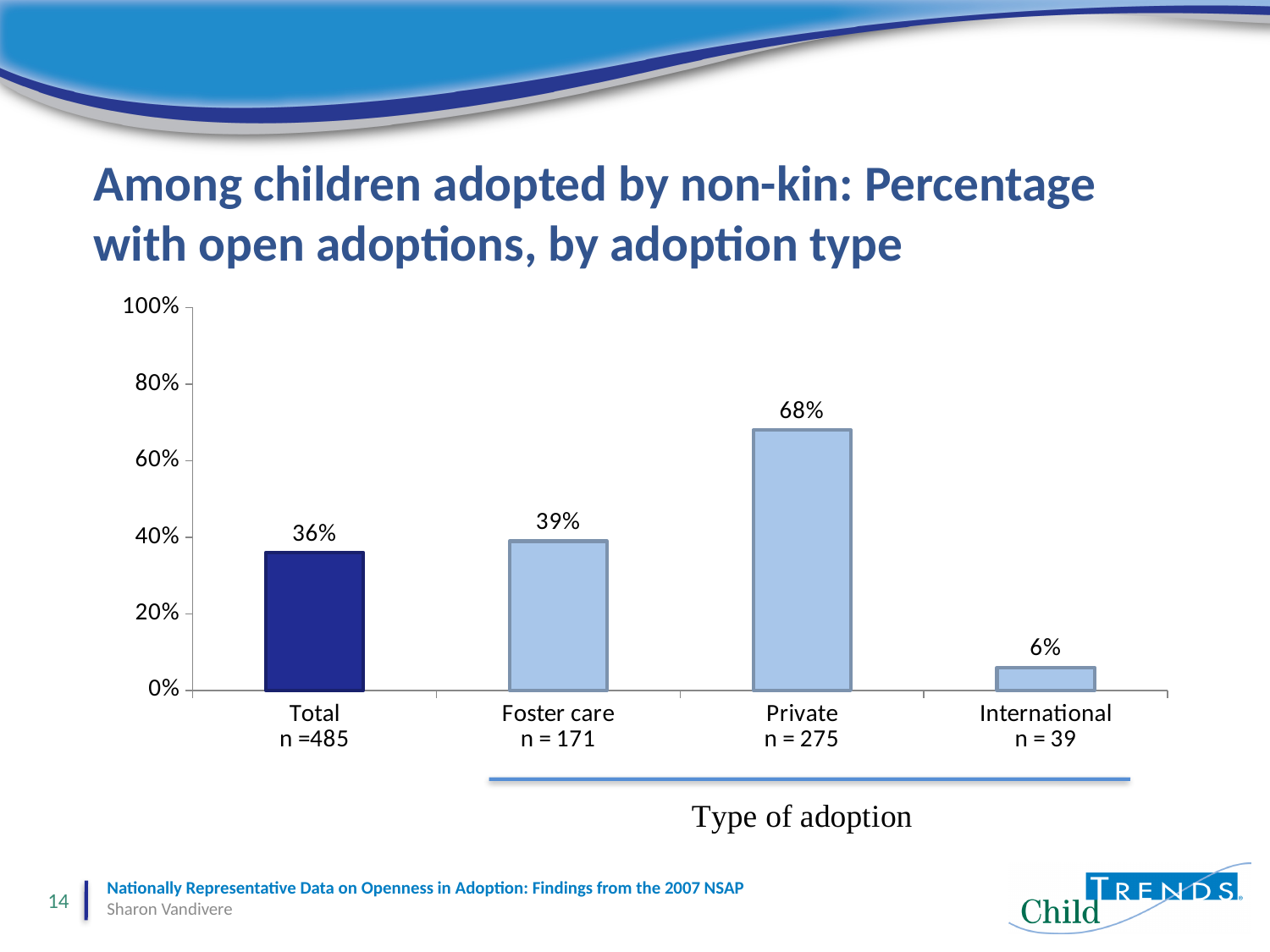
Which is larger, the value for Foster care or the value for Total? Foster care What is the value shown for the Private adoption type? 68% What percentage of children adopted from foster care have open adoptions? 39% Which adoption type has the lowest percentage of open adoptions? International What kind of chart is shown on the slide? Bar chart How many bars are shown in the chart? 4 What is the value shown for the Total bar? 36% What is the sample size (n) shown for the Private category? 275 What is the difference in percentage points between Private and Foster care? 29 What is the difference in percentage points between Foster care and International? 33 Which adoption type has the highest percentage of open adoptions? Private What is the value shown for International adoptions? 6%